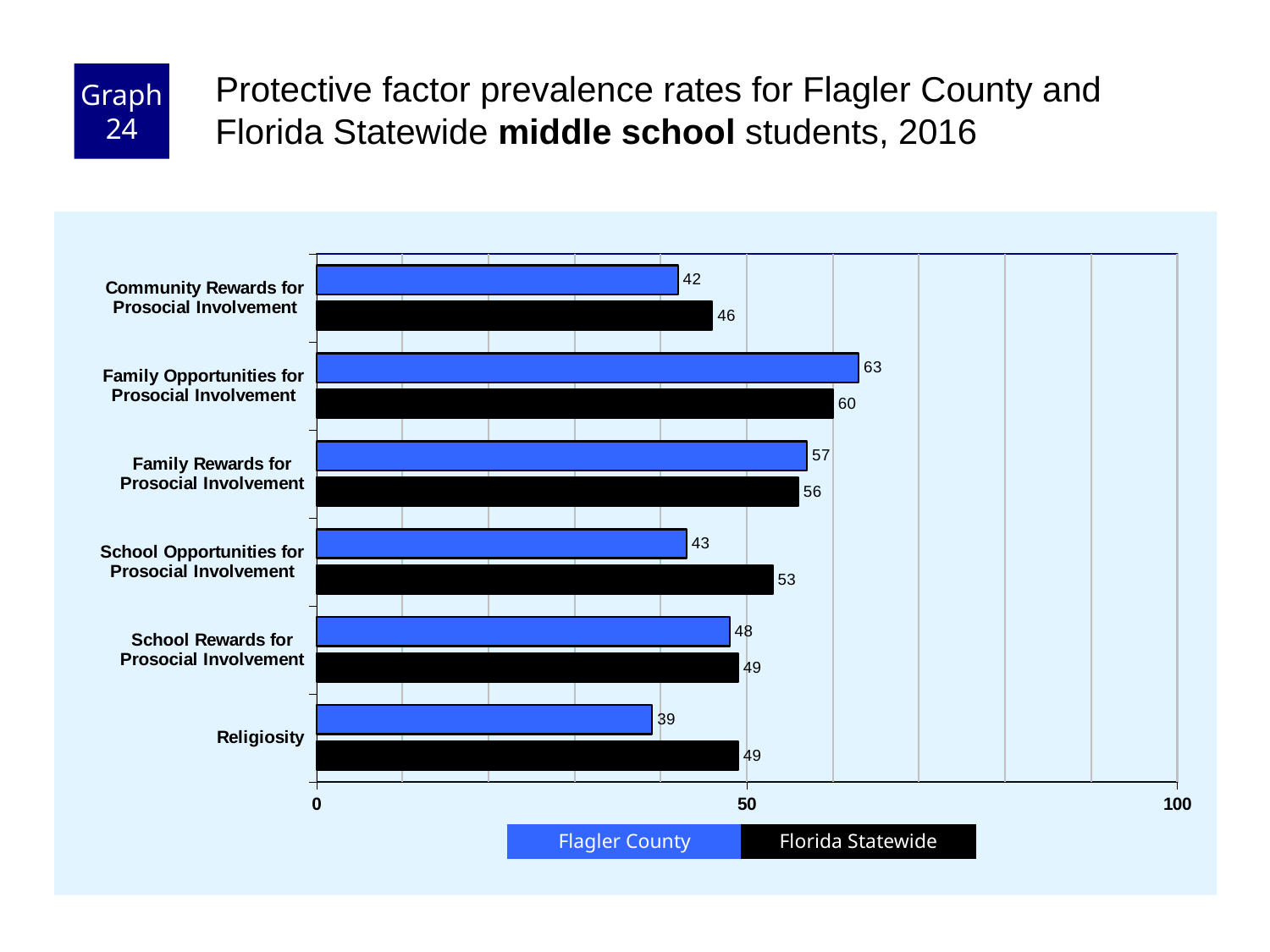
What is the difference between the Florida Statewide and Flagler County values for School Opportunities for Prosocial Involvement? 10 What kind of chart is shown on the slide? Bar chart What is the difference between the Florida Statewide and Flagler County values for Religiosity? 10 Which category has the highest Flagler County value? Family Opportunities for Prosocial Involvement How many series does the legend list? 2 Which category has the lowest Florida Statewide value? Community Rewards for Prosocial Involvement What is the Flagler County value for Family Opportunities for Prosocial Involvement? 63 What is the Florida Statewide value for School Opportunities for Prosocial Involvement? 53 What is the Flagler County value for Religiosity? 39 For Family Rewards for Prosocial Involvement, which is larger: the Flagler County value or the Florida Statewide value? Flagler County How many protective factor categories are shown on the chart? 6 Which category has the lowest Flagler County value? Religiosity